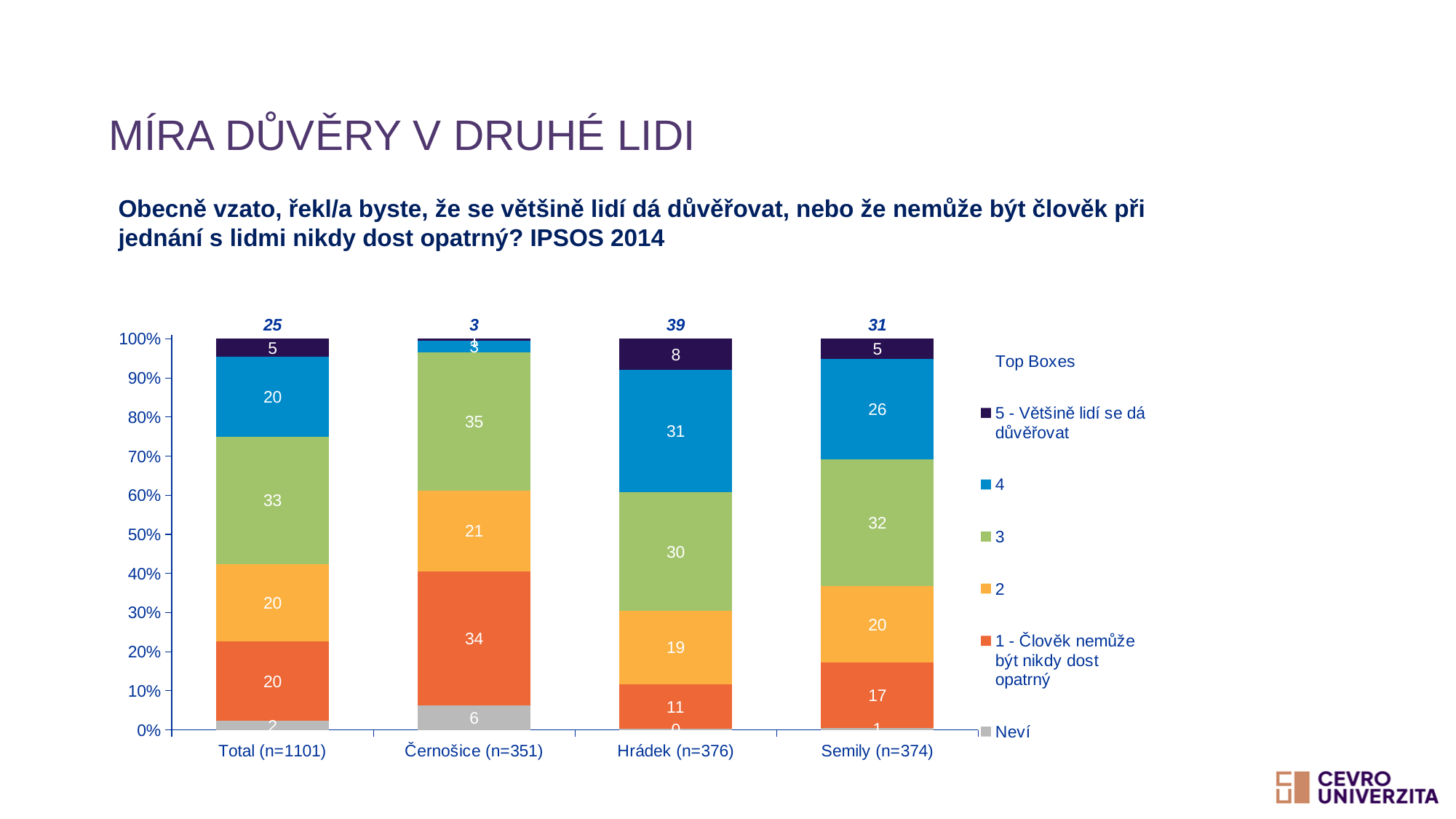
What is the value for series "3" in the Total (n=1101) bar? 33 How many series does the legend list? 7 What kind of chart is shown on the slide? Stacked bar chart Which has the larger value for series "4": Hrádek (n=376) or Semily (n=374)? Hrádek (n=376) Which category has the highest Top Boxes value shown above the bars? Hrádek (n=376) Which category has the lowest Top Boxes value shown above the bars? Černošice (n=351) What is the difference between the Top Boxes values for Hrádek (n=376) and Semily (n=374)? 8 What is the "Neví" value for Hrádek (n=376)? 0 What is the value for series "4" in the Hrádek (n=376) bar? 31 How many categories are shown on the x axis? 4 What is the value for "1 - Člověk nemůže být nikdy dost opatrný" in the Černošice (n=351) bar? 34 What is the value for "5 - Většině lidí se dá důvěřovat" in the Semily (n=374) bar? 5